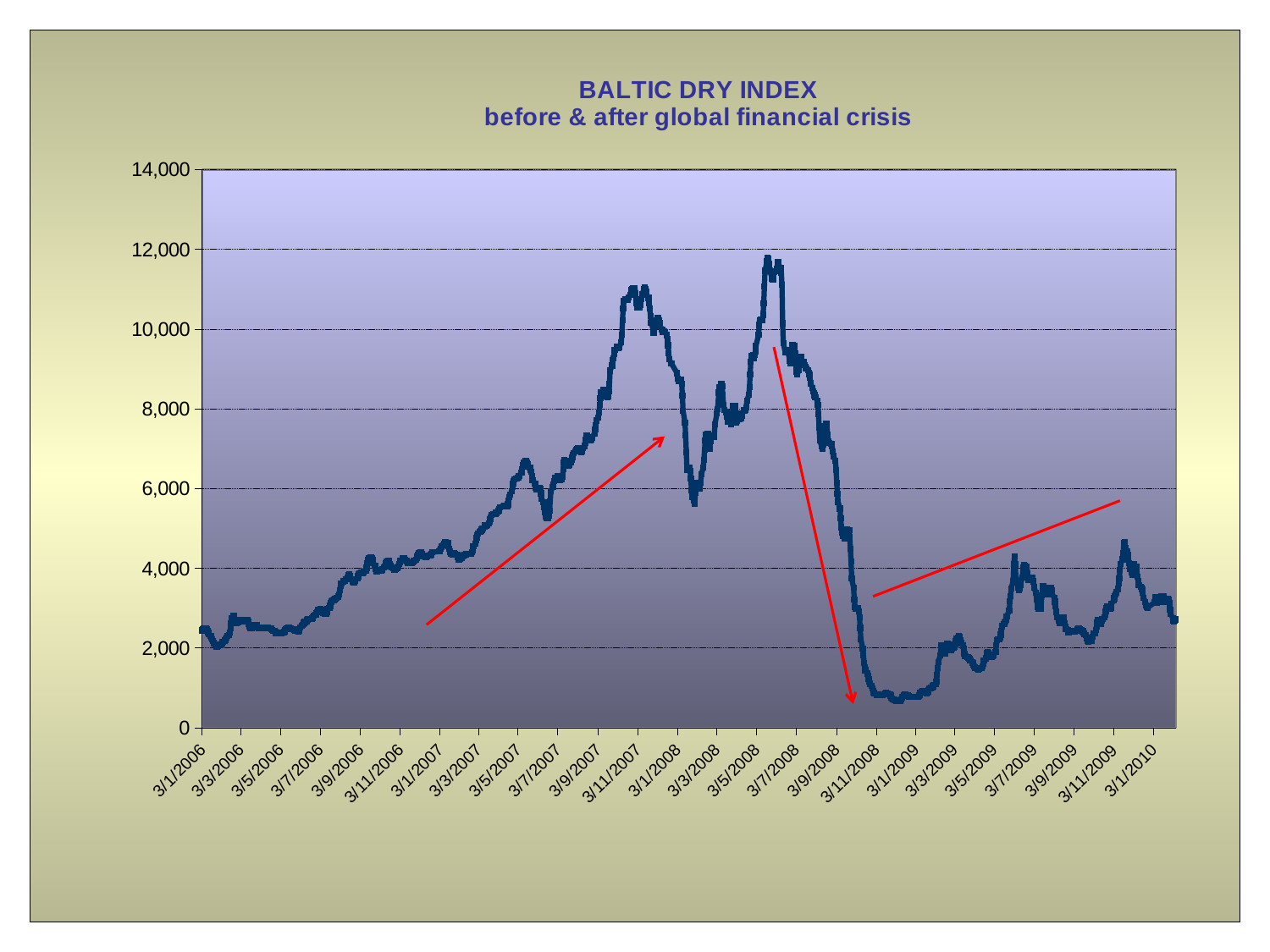
Is the value of the index at 3/11/2008 greater or less than 2,000? less Does the index rise or fall between 3/7/2008 and 3/11/2008? fall Is the value of the index at 3/1/2010 greater or less than 4,000? less What is the title of the chart? BALTIC DRY INDEX before & after global financial crisis What is the highest value shown on the vertical axis? 14,000 In which year does the index reach its highest value on the chart? 2008 Does the index rise or fall between 3/1/2006 and 3/11/2007? rise Is the value of the index at 3/1/2009 greater or less than 2,000? less What kind of chart is shown on the slide? line chart Which is larger, the index value at 3/11/2007 or at 3/11/2008? 3/11/2007